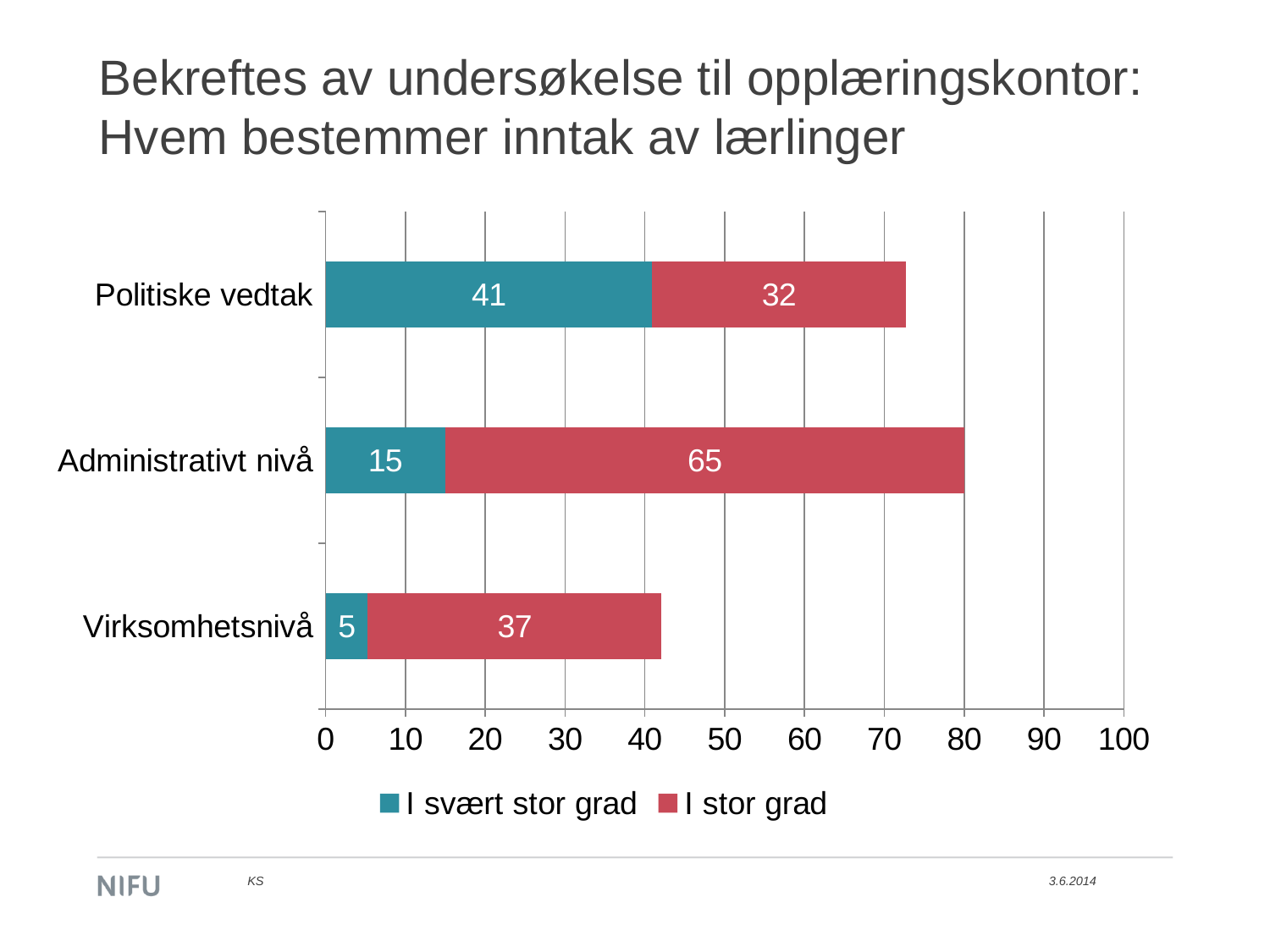
What is the difference between the "I stor grad" values for Administrativt nivå and Virksomhetsnivå? 28 What is the value of "I stor grad" for Administrativt nivå? 65 What is the total of the stacked bar for Politiske vedtak? 73 What kind of chart is shown on the slide? Stacked bar chart What is the value of "I svært stor grad" for Virksomhetsnivå? 5 How many categories are shown on the chart? 3 How many series does the legend list? 2 What is the value of "I svært stor grad" for Politiske vedtak? 41 Which category has the lowest value for "I stor grad"? Politiske vedtak Which is larger: "I svært stor grad" for Politiske vedtak or "I svært stor grad" for Administrativt nivå? Politiske vedtak Which category has the highest value for "I svært stor grad"? Politiske vedtak What is the total of the stacked bar for Administrativt nivå? 80